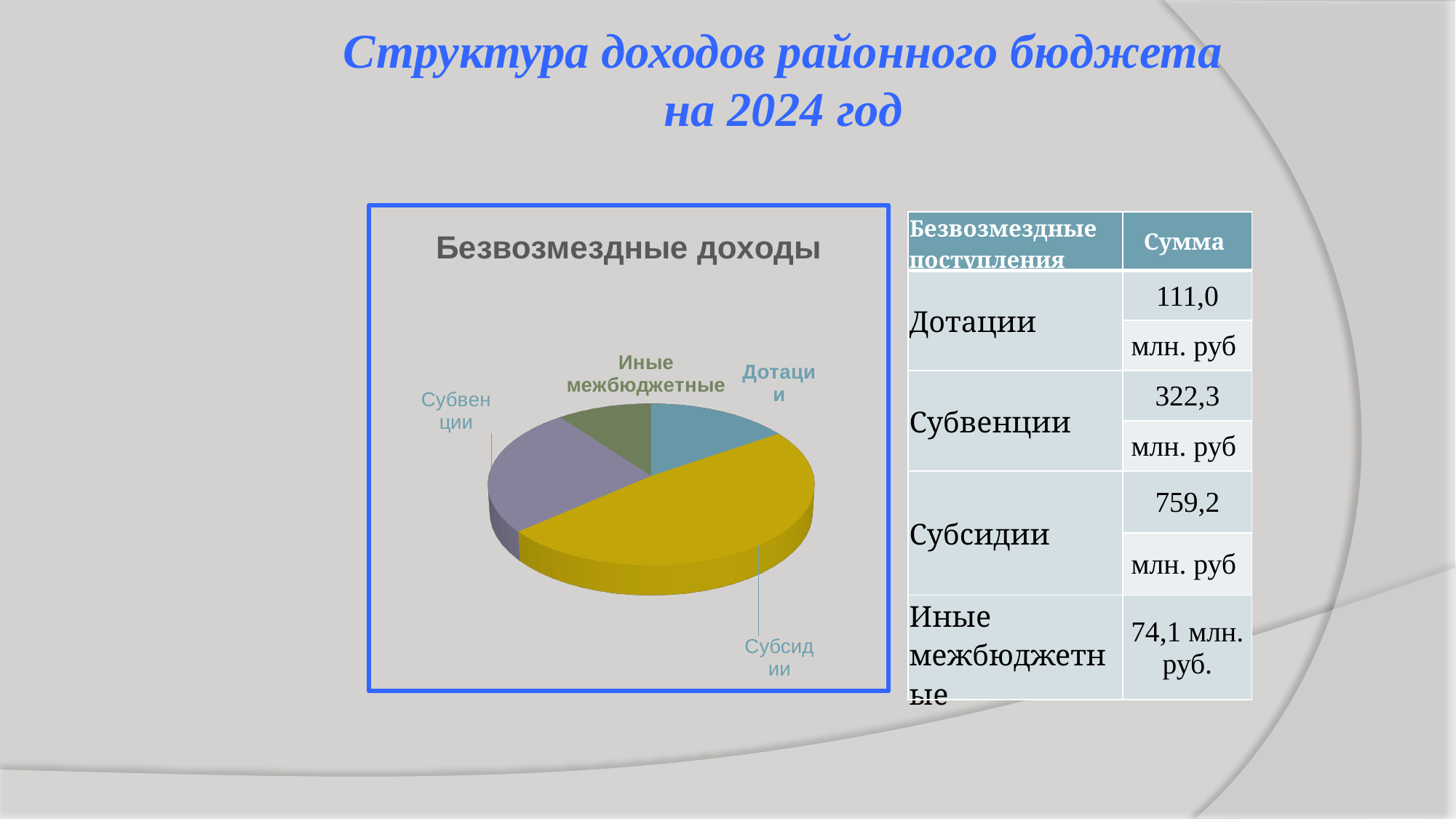
What colour is the Субсидии slice? Yellow What kind of chart is shown on the slide? Pie chart Which category has the largest slice of the pie? Субсидии Which category has the smallest slice of the pie? Иные межбюджетные What is the value for Субвенции? 322,3 млн. руб What is the value for Иные межбюджетные? 74,1 млн. руб. What is the title of the chart? Безвозмездные доходы How many slices does the pie chart have? 4 What is the value for Дотации? 111,0 млн. руб What is the value for Субсидии? 759,2 млн. руб Which is larger, Субвенции or Дотации? Субвенции What is the difference between Субсидии and Субвенции? 436,9 млн. руб